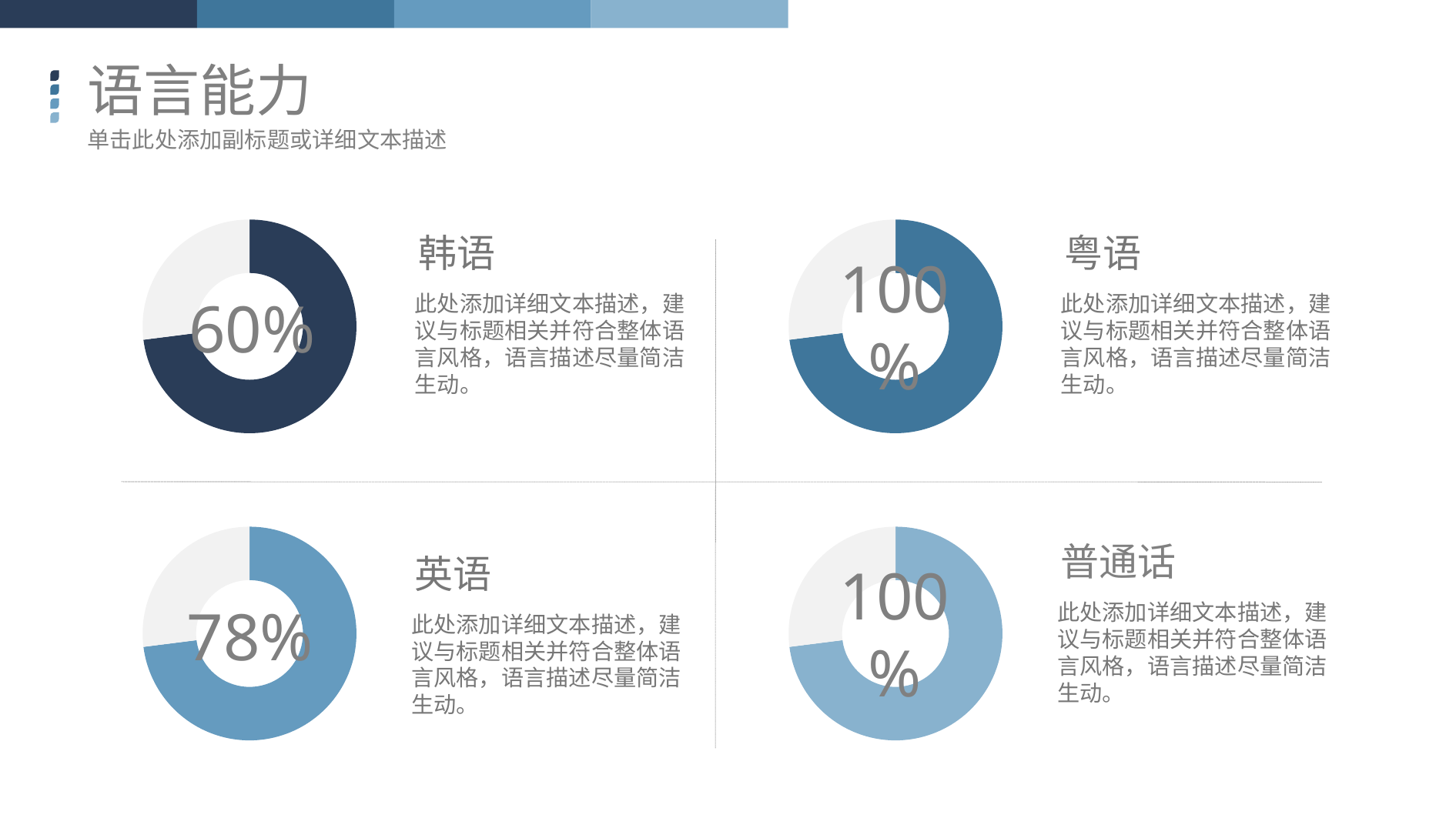
Which is larger, the percentage for 韩语 or the percentage for 英语? 英语 Is the percentage for 韩语 greater or less than 50%? greater What percentage is shown in the 普通话 donut chart? 100% What is the title of the slide containing the donut charts? 语言能力 What percentage is shown in the 韩语 donut chart? 60% How many donut charts are on the slide? 4 What percentage is shown in the 英语 donut chart? 78% What is the difference between the percentage for 英语 and the percentage for 韩语? 18% What percentage is shown in the 粤语 donut chart? 100% Which language's donut chart is drawn in the darkest navy colour? 韩语 Which language has the lowest percentage shown on the slide? 韩语 What kind of chart is used for each language on the slide? Donut (pie) chart